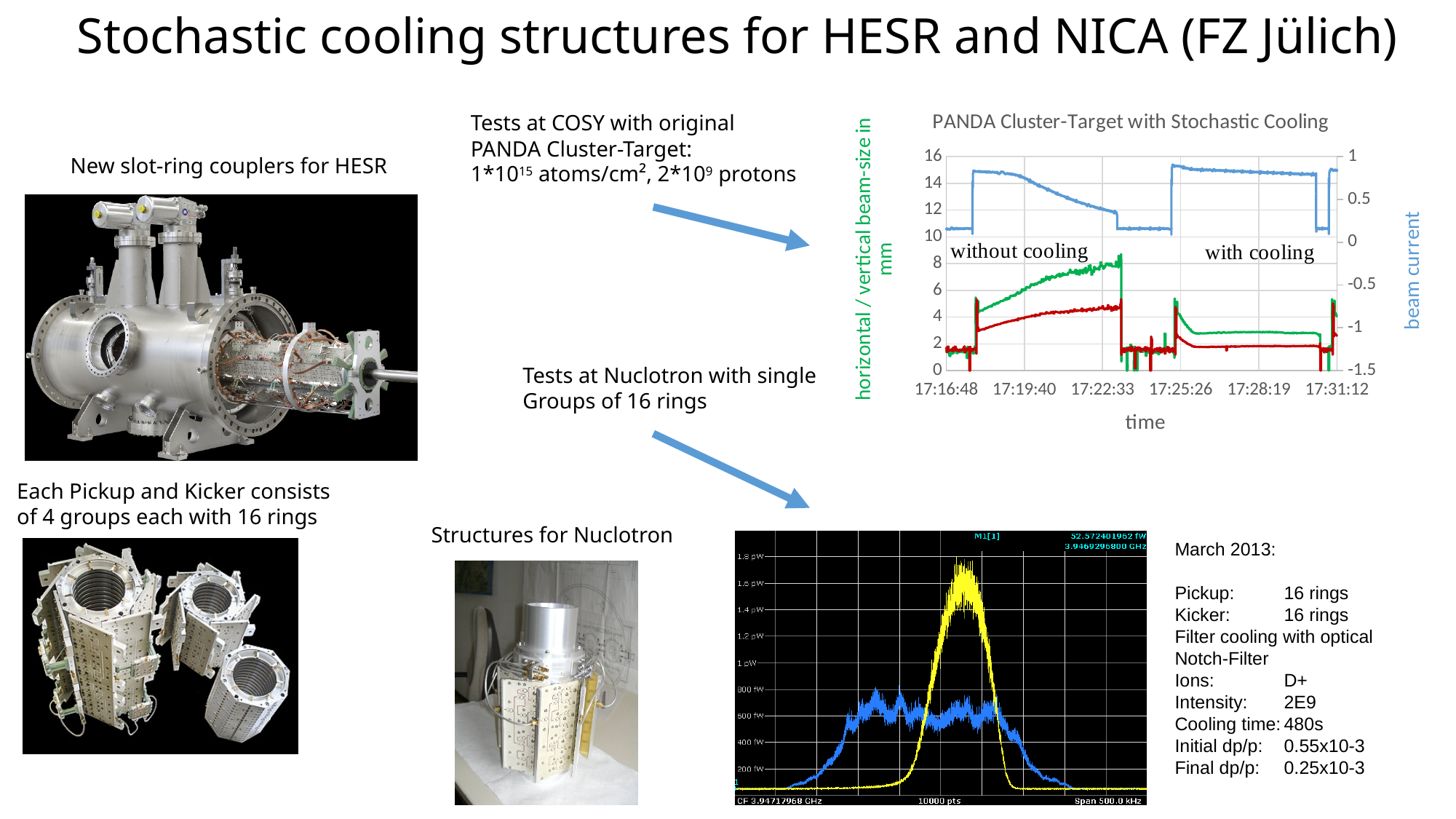
In the 'PANDA Cluster-Target with Stochastic Cooling' chart, what is the label of the right vertical axis? beam current In the 'PANDA Cluster-Target with Stochastic Cooling' chart, which line is higher just before 17:22:33, the green line or the red line? green line In the 'PANDA Cluster-Target with Stochastic Cooling' chart, does the green line rise or fall between 17:19:40 and 17:22:33? rise In the 'PANDA Cluster-Target with Stochastic Cooling' chart, what is the label of the left vertical axis? horizontal / vertical beam-size in mm What kind of chart is the spectrum chart at the bottom of the slide? line chart In the spectrum chart at the bottom of the slide, which trace reaches the higher peak, the yellow trace or the blue trace? yellow trace In the 'PANDA Cluster-Target with Stochastic Cooling' chart, is the red line's value just before 17:22:33 greater or less than 4 mm? greater In the 'PANDA Cluster-Target with Stochastic Cooling' chart, how many time labels are shown on the x axis? 6 In the 'PANDA Cluster-Target with Stochastic Cooling' chart, is the green line's value during the 'with cooling' plateau (around 17:28:19) greater or less than 4 mm? less What kind of chart is the 'PANDA Cluster-Target with Stochastic Cooling' chart? line chart In the 'PANDA Cluster-Target with Stochastic Cooling' chart, what is the highest tick value on the left vertical axis? 16 In the 'PANDA Cluster-Target with Stochastic Cooling' chart, is the green line's peak in the 'without cooling' period higher or lower than its plateau in the 'with cooling' period? higher